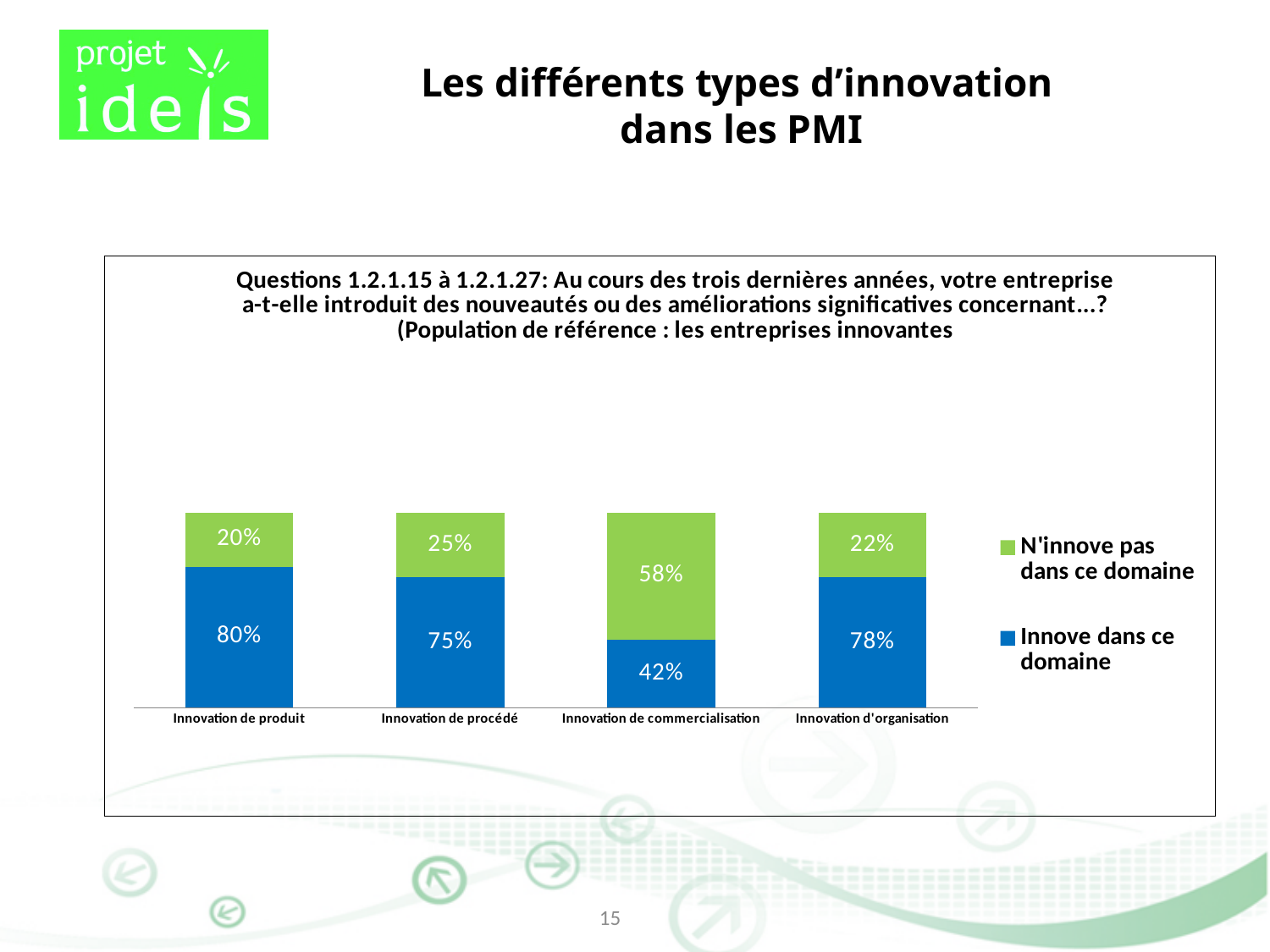
What is the value of 'Innove dans ce domaine' for 'Innovation d'organisation'? 78% Which is larger: the 'N'innove pas dans ce domaine' value for 'Innovation de procédé' or for 'Innovation d'organisation'? Innovation de procédé What is the value of 'N'innove pas dans ce domaine' for 'Innovation de commercialisation'? 58% What is the difference between the 'Innove dans ce domaine' values for 'Innovation de produit' and 'Innovation de procédé'? 5% Which category has the lowest value for 'Innove dans ce domaine'? Innovation de commercialisation What kind of chart is shown on the slide? Stacked bar chart What is the total of the stacked bar for 'Innovation de commercialisation'? 100% How many categories are shown on the x axis? 4 What percentage of companies innovate in the 'Innovation de produit' domain? 80% How many series does the legend list? 2 Which category has the highest value for 'Innove dans ce domaine'? Innovation de produit Which colour represents 'Innove dans ce domaine' in the legend? Blue